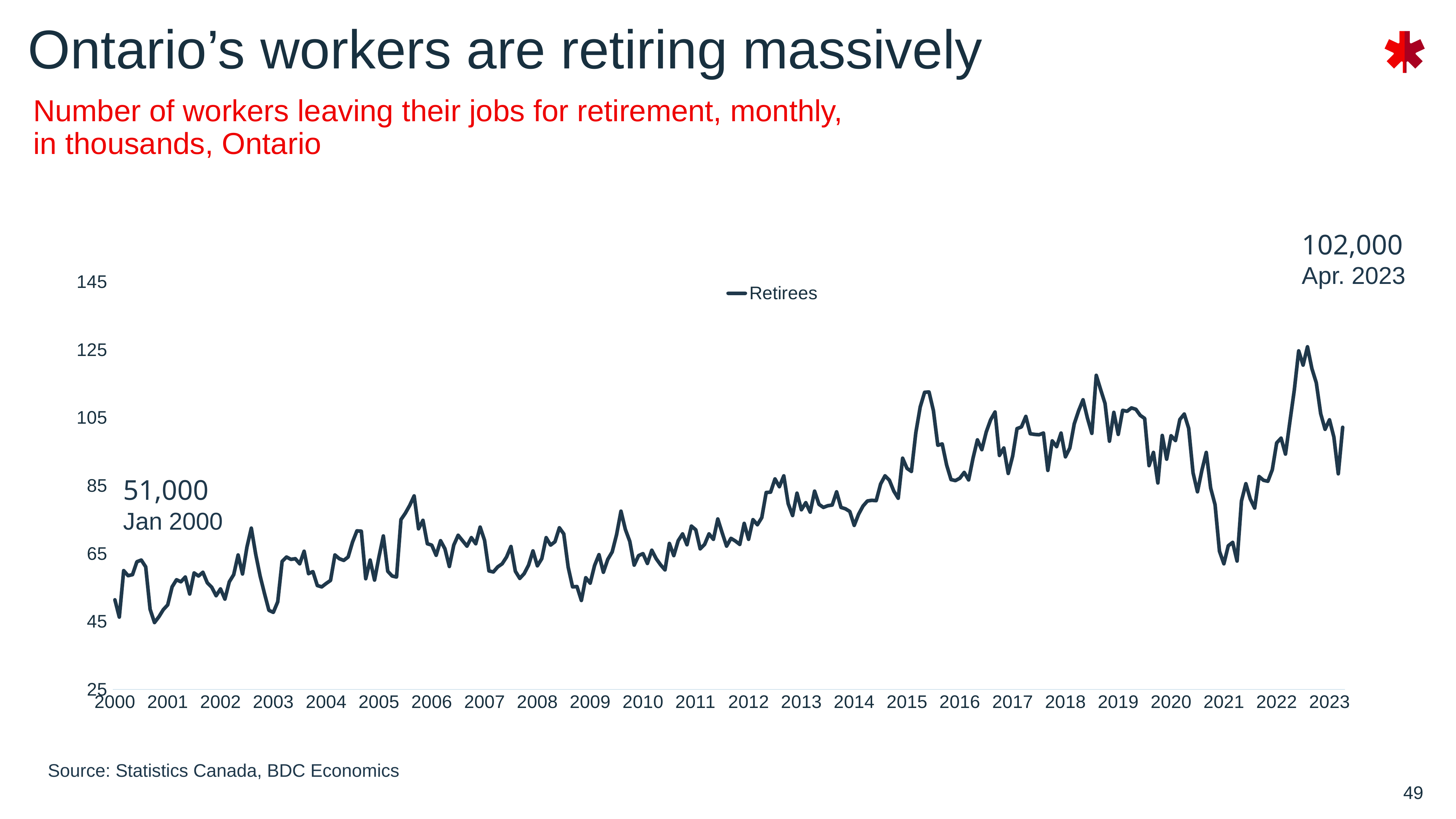
How many year labels are shown on the x axis? 24 What is the number of retirees labelled for Jan 2000? 51,000 Which is larger, the value for Jan 2000 or the value for Apr. 2023? Apr. 2023 In which year does the line reach its highest peak? 2022 What is the name of the series shown in the legend? Retirees Do the values generally rise or fall from 2000 to 2023? rise What is the difference between the Apr. 2023 value and the Jan 2000 value? 51,000 Is the peak value reached in 2022 greater or less than 105? greater How many series does the legend list? 1 What kind of chart is shown on the slide? line chart Is the value for Jan 2000 greater or less than 65? less What is the number of retirees labelled for Apr. 2023? 102,000